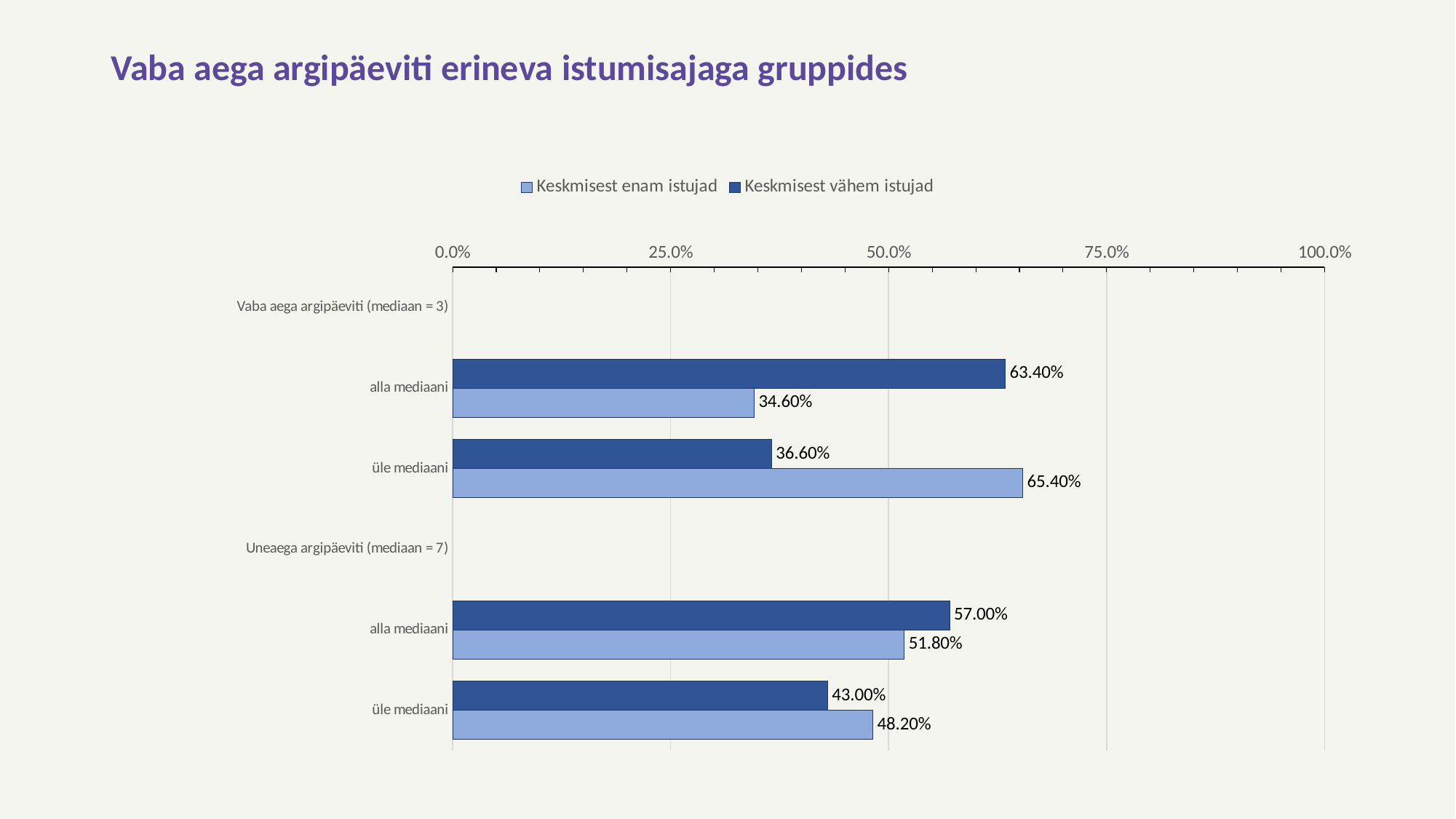
What is the value for Keskmisest enam istujad in the 'üle mediaani' category under Vaba aega argipäeviti (mediaan = 3)? 65.40% What is the value for Keskmisest enam istujad in the 'alla mediaani' category under Uneaega argipäeviti (mediaan = 7)? 51.80% What kind of chart is shown on the slide? bar chart Is the value for Keskmisest vähem istujad in the 'üle mediaani' category under Vaba aega argipäeviti (mediaan = 3) greater or less than 50.0%? less How many series does the legend list? 2 Which series has the highest value in the 'üle mediaani' category under Vaba aega argipäeviti (mediaan = 3)? Keskmisest enam istujad What is the value for Keskmisest vähem istujad in the 'üle mediaani' category under Uneaega argipäeviti (mediaan = 7)? 43.00% What is the difference between Keskmisest vähem istujad and Keskmisest enam istujad in the 'alla mediaani' category under Vaba aega argipäeviti (mediaan = 3)? 28.80% What is the value for Keskmisest vähem istujad in the 'alla mediaani' category under Vaba aega argipäeviti (mediaan = 3)? 63.40% What is the difference between Keskmisest vähem istujad and Keskmisest enam istujad in the 'alla mediaani' category under Uneaega argipäeviti (mediaan = 7)? 5.20% What is the title of the slide? Vaba aega argipäeviti erineva istumisajaga gruppides In the 'üle mediaani' category under Uneaega argipäeviti (mediaan = 7), which series has the larger value? Keskmisest enam istujad